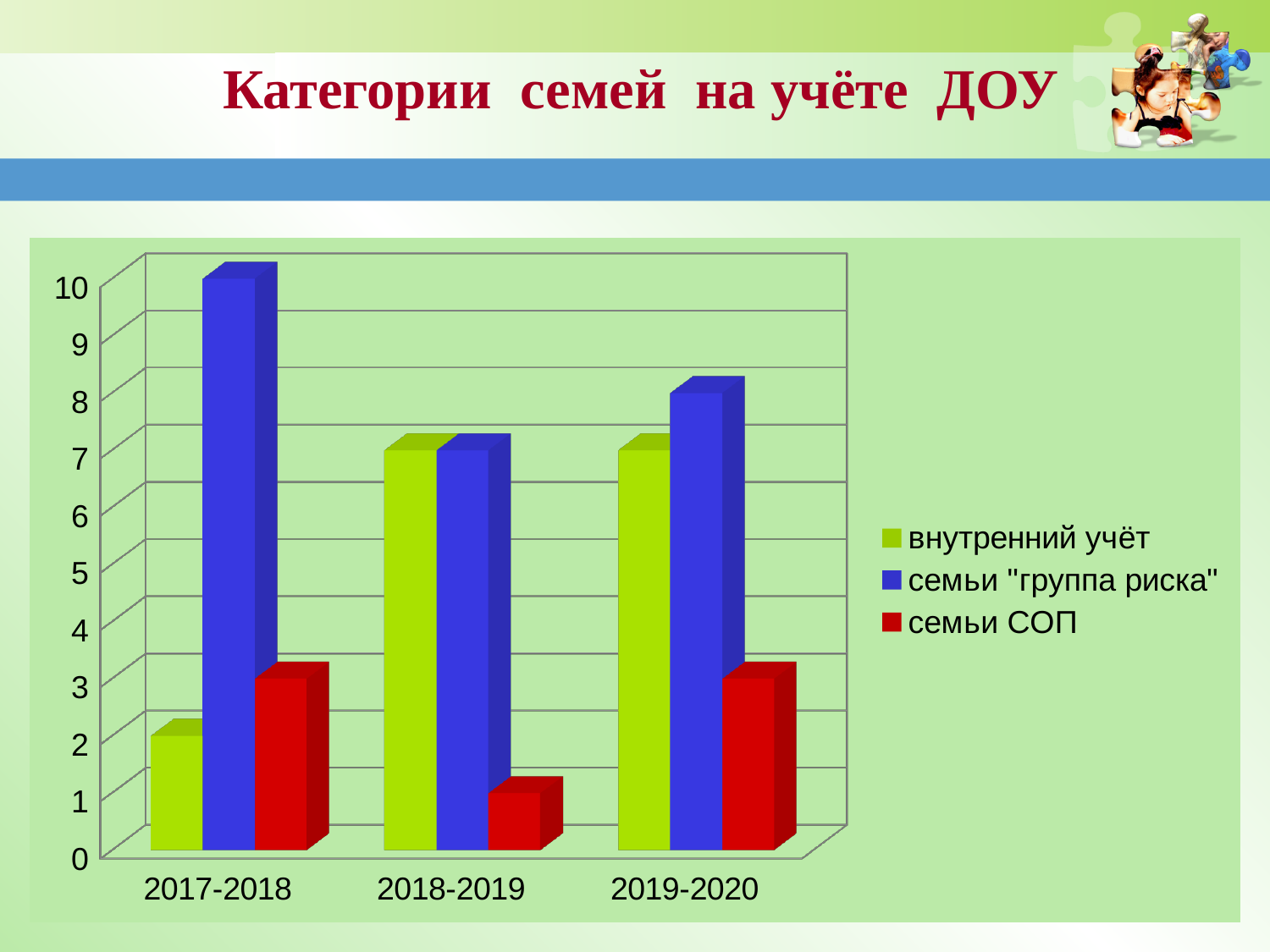
What is the value for семьи "группа риска" in 2017-2018? 10 How many series does the legend list? 3 What is the value for семьи "группа риска" in 2019-2020? 8 What kind of chart is shown on the slide? bar chart What is the value for внутренний учёт in 2017-2018? 2 How many categories are shown on the x axis? 3 In which period is the value for семьи "группа риска" highest? 2017-2018 What is the value for семьи СОП in 2018-2019? 1 What is the title of the chart on the slide? Категории семей на учёте ДОУ Is the value for семьи "группа риска" in 2018-2019 greater or less than 5? greater Which is larger in 2019-2020: внутренний учёт or семьи СОП? внутренний учёт In which period is the value for внутренний учёт lowest? 2017-2018